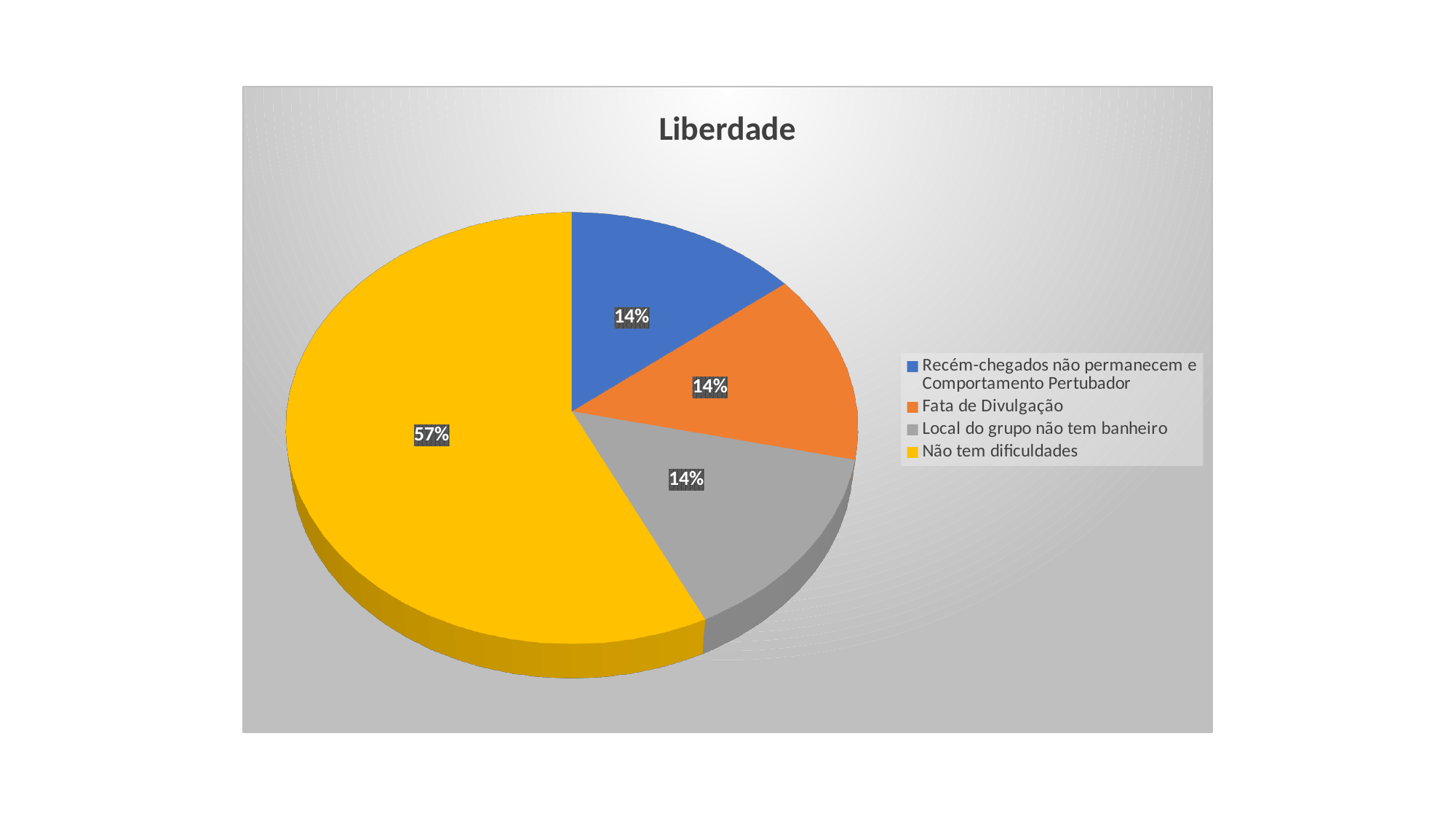
What is the title of the chart? Liberdade What share of the pie does "Fata de Divulgação" represent? 14% Which is larger, the slice for "Não tem dificuldades" or the slice for "Local do grupo não tem banheiro"? Não tem dificuldades What kind of chart is shown on the slide? pie chart Which category has the largest slice of the pie? Não tem dificuldades What share of the pie does "Não tem dificuldades" represent? 57% What is the value shown for "Recém-chegados não permanecem e Comportamento Pertubador"? 14% What colour is the slice for "Não tem dificuldades"? yellow How many entries does the legend list? 4 What share of the pie does "Local do grupo não tem banheiro" represent? 14% How many slices does the pie chart have? 4 What is the difference between the share for "Não tem dificuldades" and the share for "Fata de Divulgação"? 43%